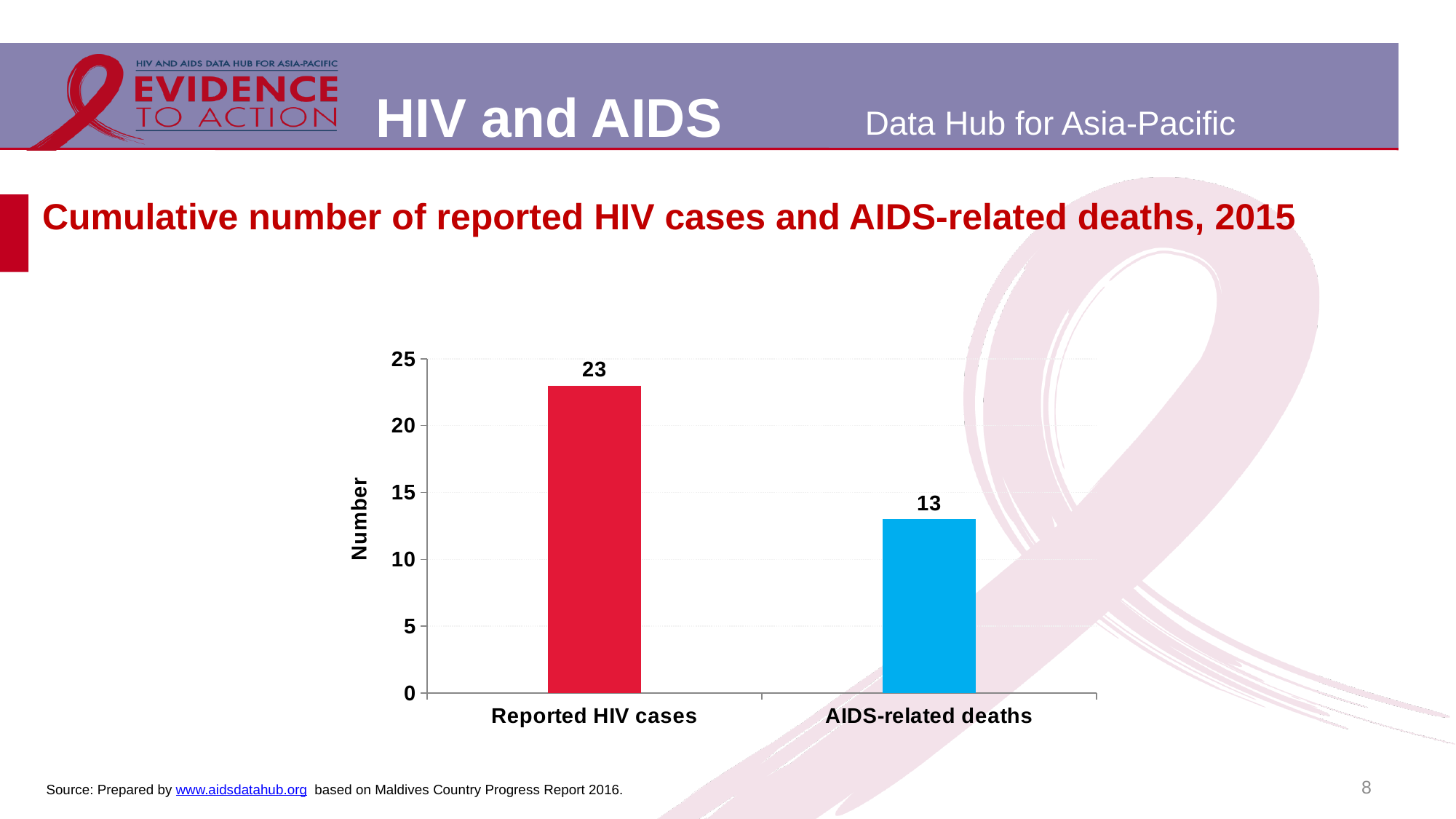
What is the maximum value shown on the vertical axis? 25 Which category has the higher value, Reported HIV cases or AIDS-related deaths? Reported HIV cases What is the difference between the number of reported HIV cases and the number of AIDS-related deaths? 10 Is the value for AIDS-related deaths greater or less than 15? less What is the cumulative number of reported HIV cases shown on the chart? 23 What colour is the bar for AIDS-related deaths? Blue What is the label of the vertical axis? Number What is the cumulative number of AIDS-related deaths shown on the chart? 13 What kind of chart is shown on the slide? Bar chart Is the value for Reported HIV cases greater or less than 20? greater Which category has the lowest value on the chart? AIDS-related deaths How many categories are plotted on the chart? 2